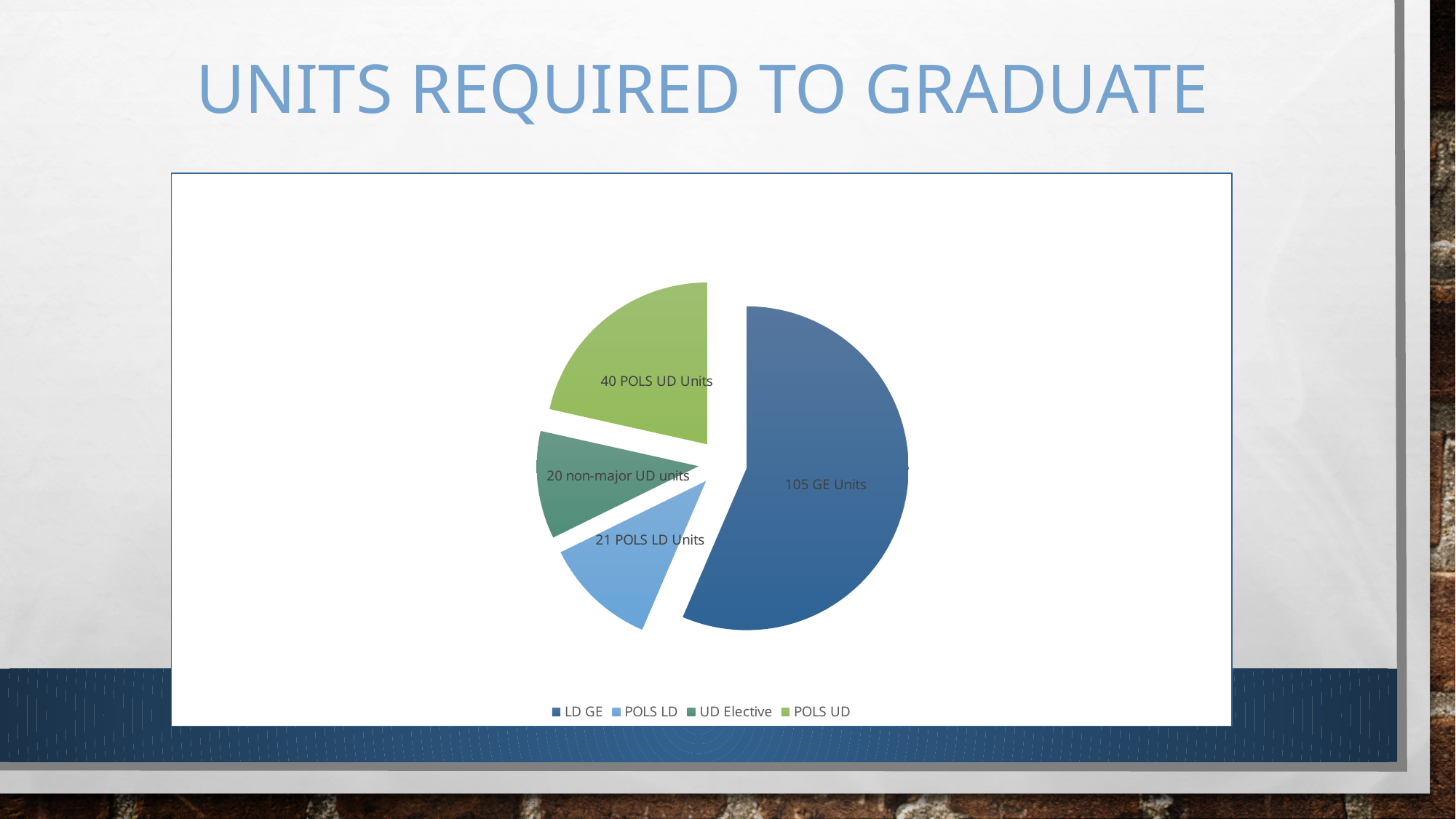
How many entries does the legend list? 4 How many POLS UD units are shown in the pie chart? 40 POLS UD Units What is the difference between the GE units and the POLS UD units? 65 How many non-major UD units are shown in the pie chart? 20 non-major UD units Which legend category has the smallest slice of the pie? UD Elective Which legend category has the largest slice of the pie? LD GE Which is larger, the POLS UD units or the POLS LD units? POLS UD units How many GE units are shown in the pie chart? 105 GE Units What type of chart is shown on the slide? pie chart How many POLS LD units are shown in the pie chart? 21 POLS LD Units How many slices does the pie chart have? 4 What is the title of the slide containing the chart? Units Required to Graduate